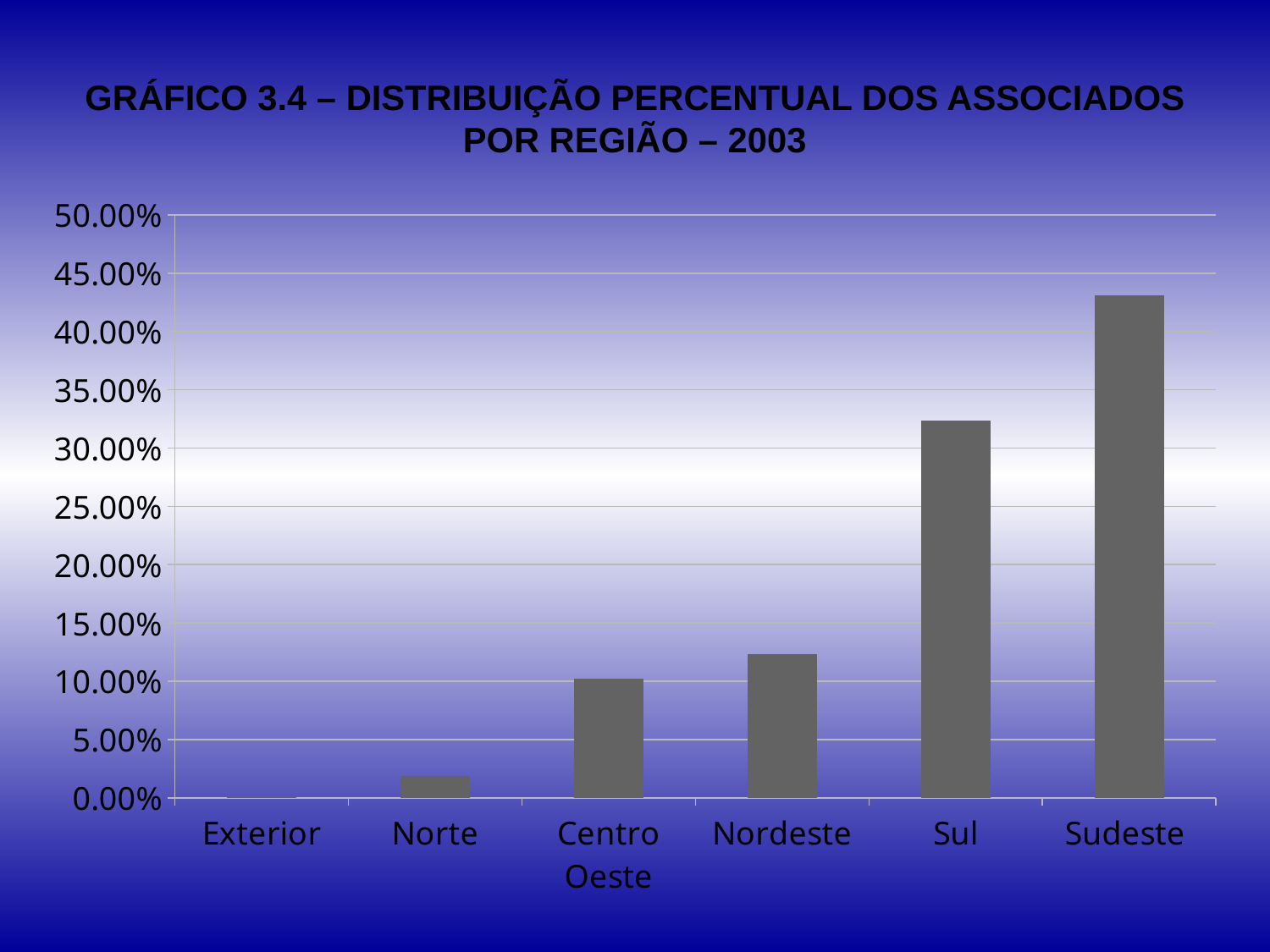
How many regions (categories) are shown on the x axis? 6 Is the value for Centro Oeste greater or less than 5.00%? greater Which region has the highest percentage of associados? Sudeste Is the value for Sul greater or less than 30.00%? greater Is the value for Sudeste greater or less than 40.00%? greater What kind of chart is shown on the slide? bar chart What year does the chart title refer to? 2003 Which region has the lowest percentage of associados? Exterior Which is larger, the value for Sul or the value for Nordeste? Sul Do the values rise or fall moving from left to right along the x axis? rise